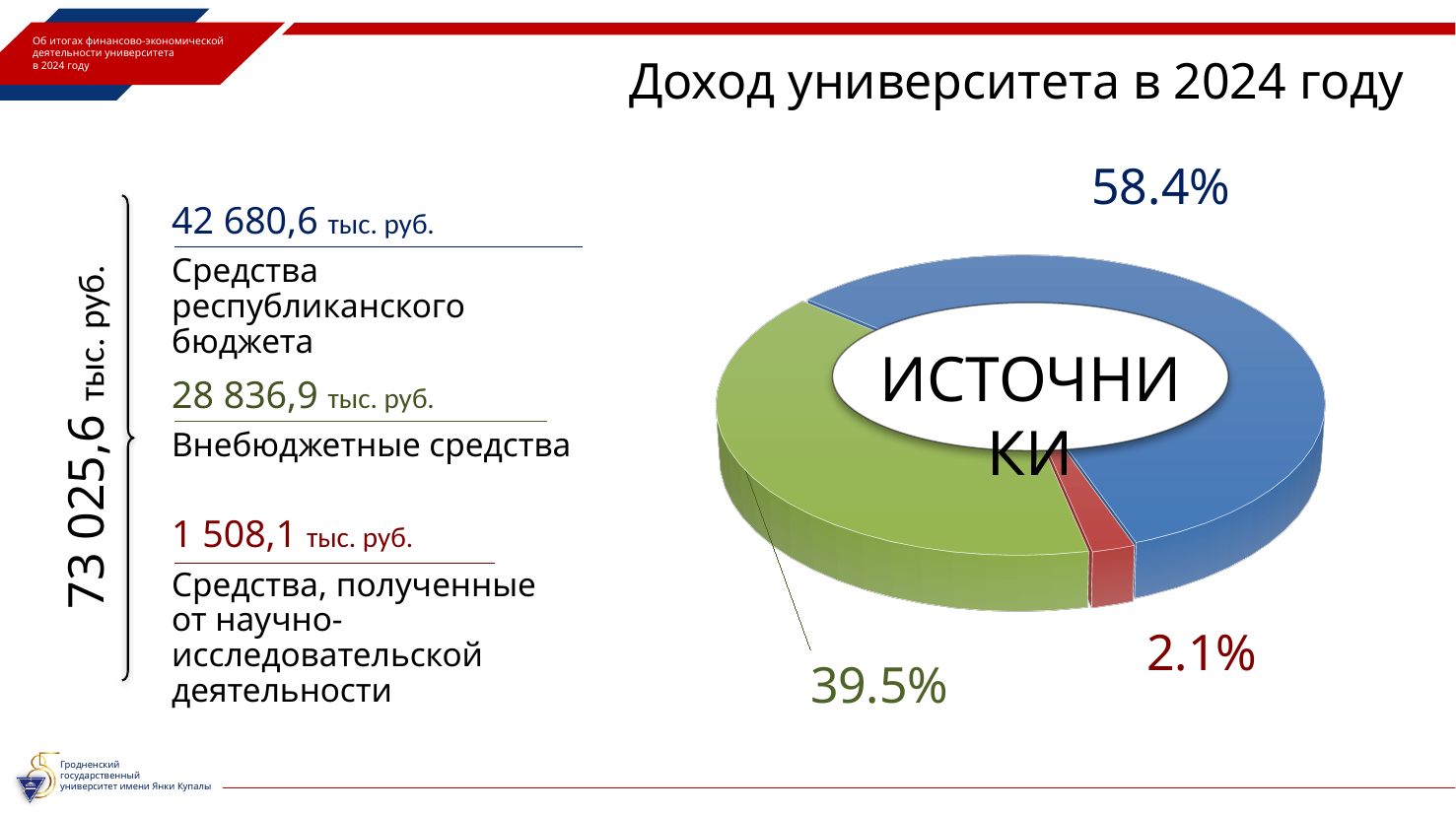
What word is written in the centre of the pie chart? ИСТОЧНИКИ What share of the pie does the blue slice (Средства республиканского бюджета) represent? 58.4% Which source of income has the smallest share of the pie? Средства, полученные от научно-исследовательской деятельности What is the difference in percentage points between the blue slice (58.4%) and the green slice (39.5%)? 18.9 Which is larger: the share of Внебюджетные средства or the share of Средства республиканского бюджета? Средства республиканского бюджета What is the total university income for 2024 shown on the slide? 73 025,6 тыс. руб. What kind of chart is shown on the slide? pie chart What share of the pie does the green slice (Внебюджетные средства) represent? 39.5% Which source of income has the largest share of the pie? Средства республиканского бюджета What share of the pie does the red slice (Средства, полученные от научно-исследовательской деятельности) represent? 2.1% What is the amount of Внебюджетные средства shown on the slide? 28 836,9 тыс. руб. How many slices does the pie chart have? 3